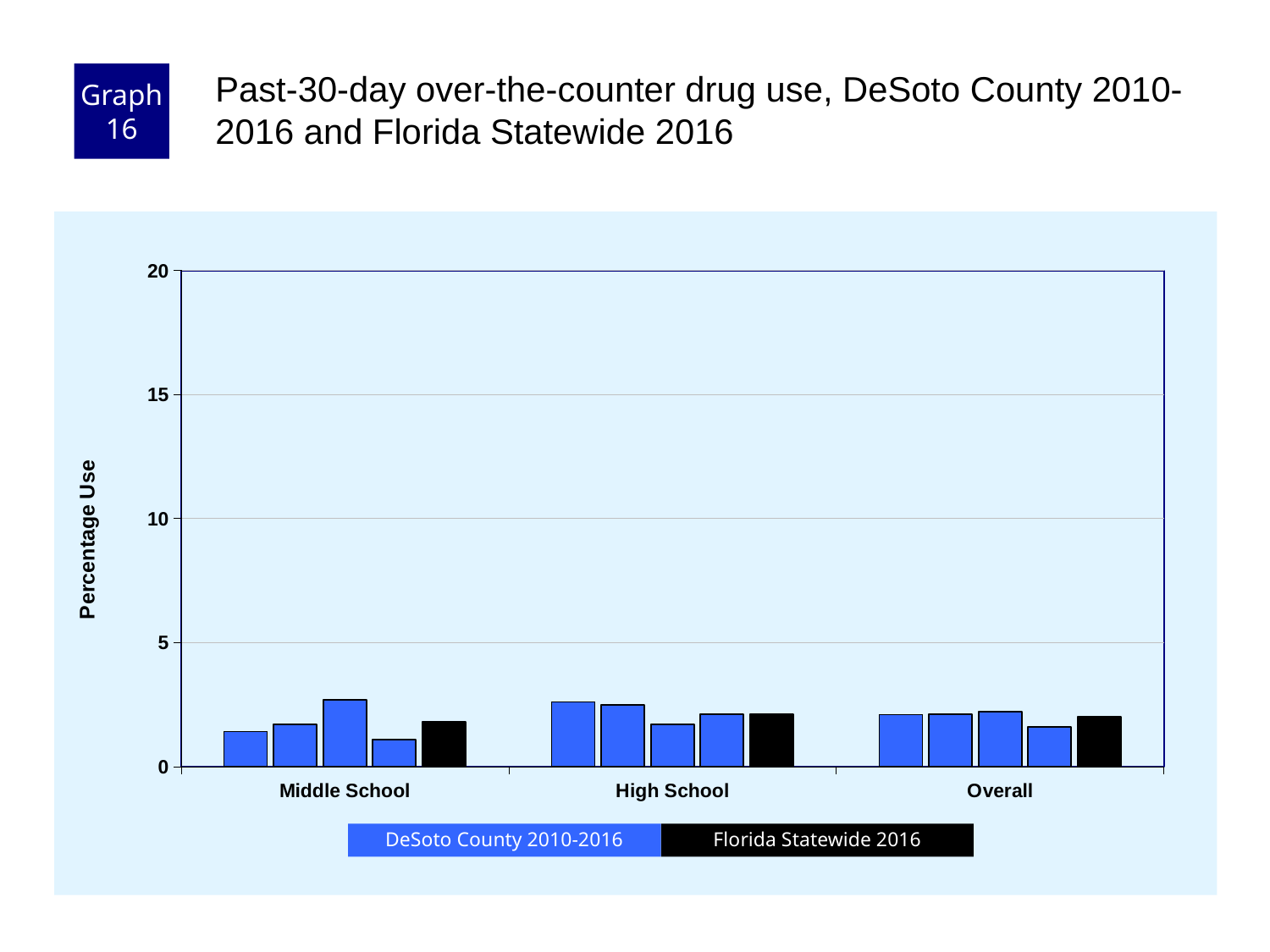
What is the highest value shown on the y axis? 20 How many categories are shown on the x axis? 3 Are any of the bars in the chart greater than 5? No In the Middle School group, is the Florida Statewide 2016 bar larger or smaller than the tallest DeSoto County bar? smaller What kind of chart is shown on the slide? bar chart Is the Florida Statewide 2016 value for High School greater or less than 5? less Is the Florida Statewide 2016 value for Overall greater or less than 10? less What is the label of the y axis? Percentage Use What colour are the Florida Statewide 2016 bars? black How many series does the legend list? 2